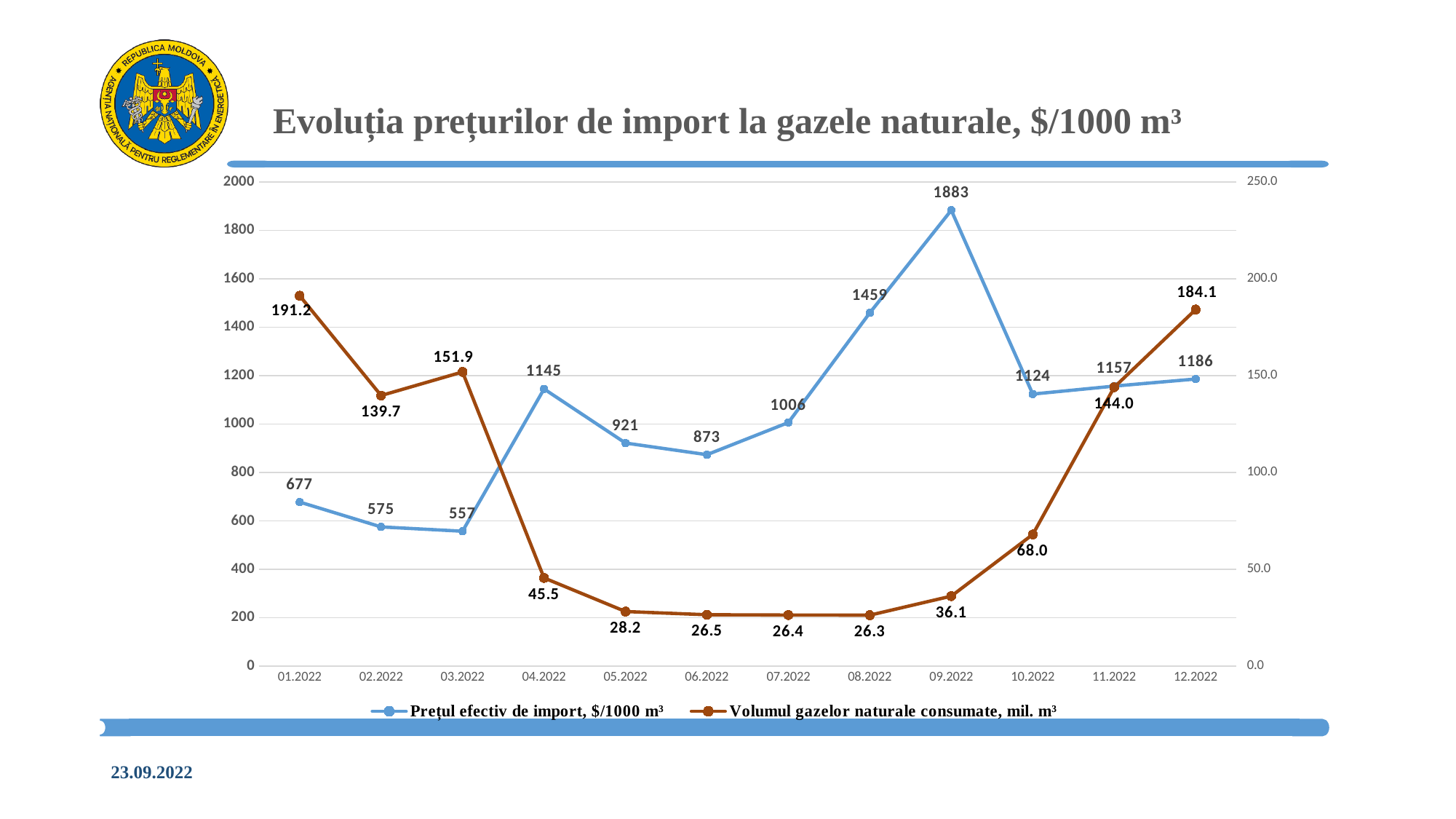
What is the value of Volumul gazelor naturale consumate for 01.2022? 191.2 What is the value of Prețul efectiv de import for 09.2022? 1883 What kind of chart is shown on the slide? line chart How many series does the legend list? 2 In which month is Prețul efectiv de import lowest? 03.2022 Does Volumul gazelor naturale consumate rise or fall from 08.2022 to 12.2022? rise In which month is Volumul gazelor naturale consumate highest? 01.2022 Which is larger: Volumul gazelor naturale consumate in 11.2022 or in 12.2022? 12.2022 What is the value of Prețul efectiv de import for 04.2022? 1145 What is the title of the chart? Evoluția prețurilor de import la gazele naturale, $/1000 m³ What is the difference between Prețul efectiv de import in 09.2022 and in 10.2022? 759 How many months are plotted on the x axis? 12